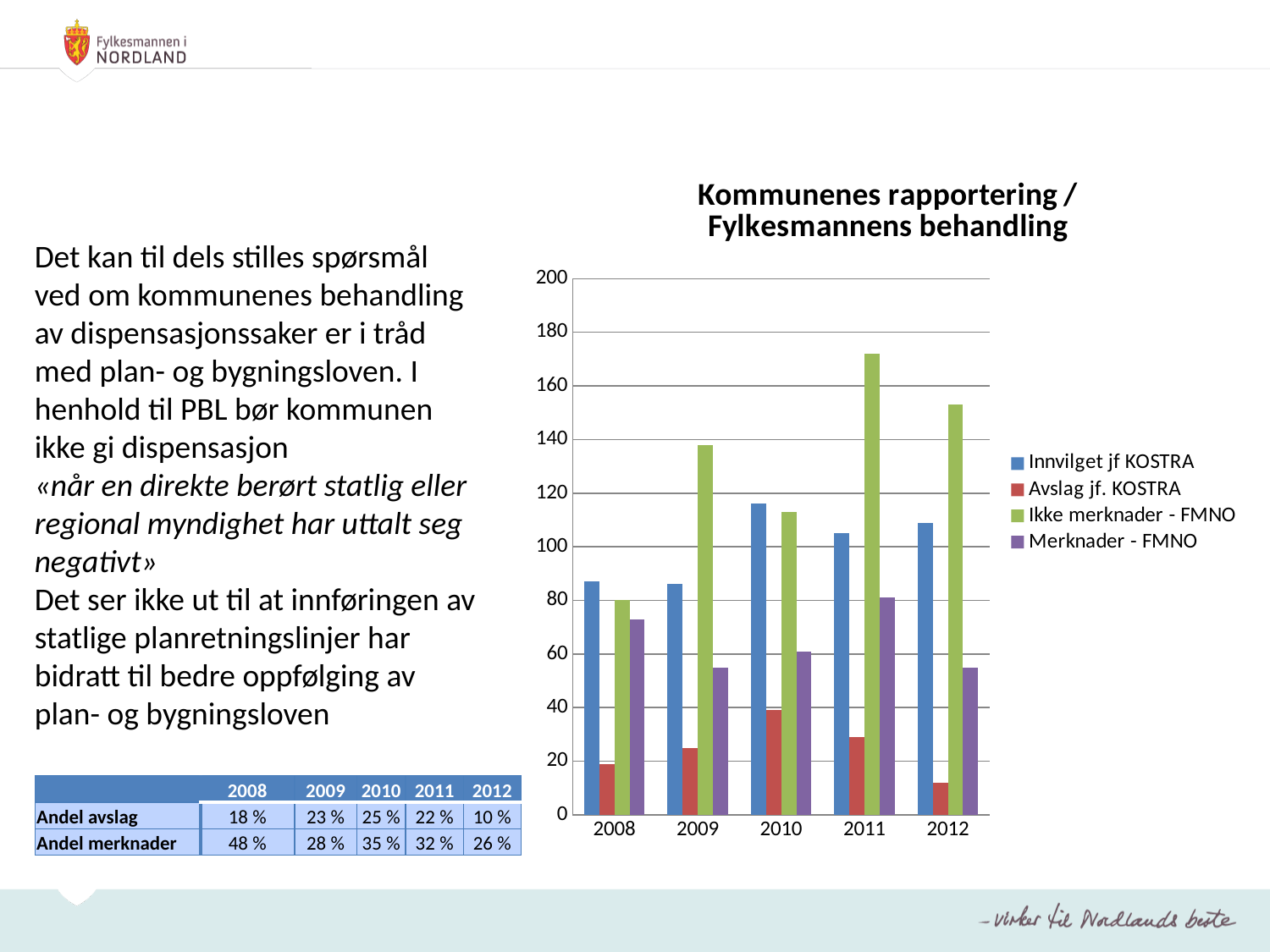
What kind of chart is shown on the slide? bar chart Is the value for Innvilget jf KOSTRA in 2010 greater or less than 100? greater What is the title of the chart? Kommunenes rapportering / Fylkesmannens behandling In which year is the value for Avslag jf. KOSTRA lowest? 2012 Is the value for Avslag jf. KOSTRA in 2012 greater or less than 20? less In which year is the value for Ikke merknader - FMNO highest? 2011 How many years are shown on the x axis of the chart? 5 Does the value for Avslag jf. KOSTRA rise or fall from 2010 to 2012? fall How many series does the chart legend list? 4 In 2011, which is larger: Ikke merknader - FMNO or Innvilget jf KOSTRA? Ikke merknader - FMNO In which year is the value for Innvilget jf KOSTRA highest? 2010 Which series is shown in green in the chart? Ikke merknader - FMNO